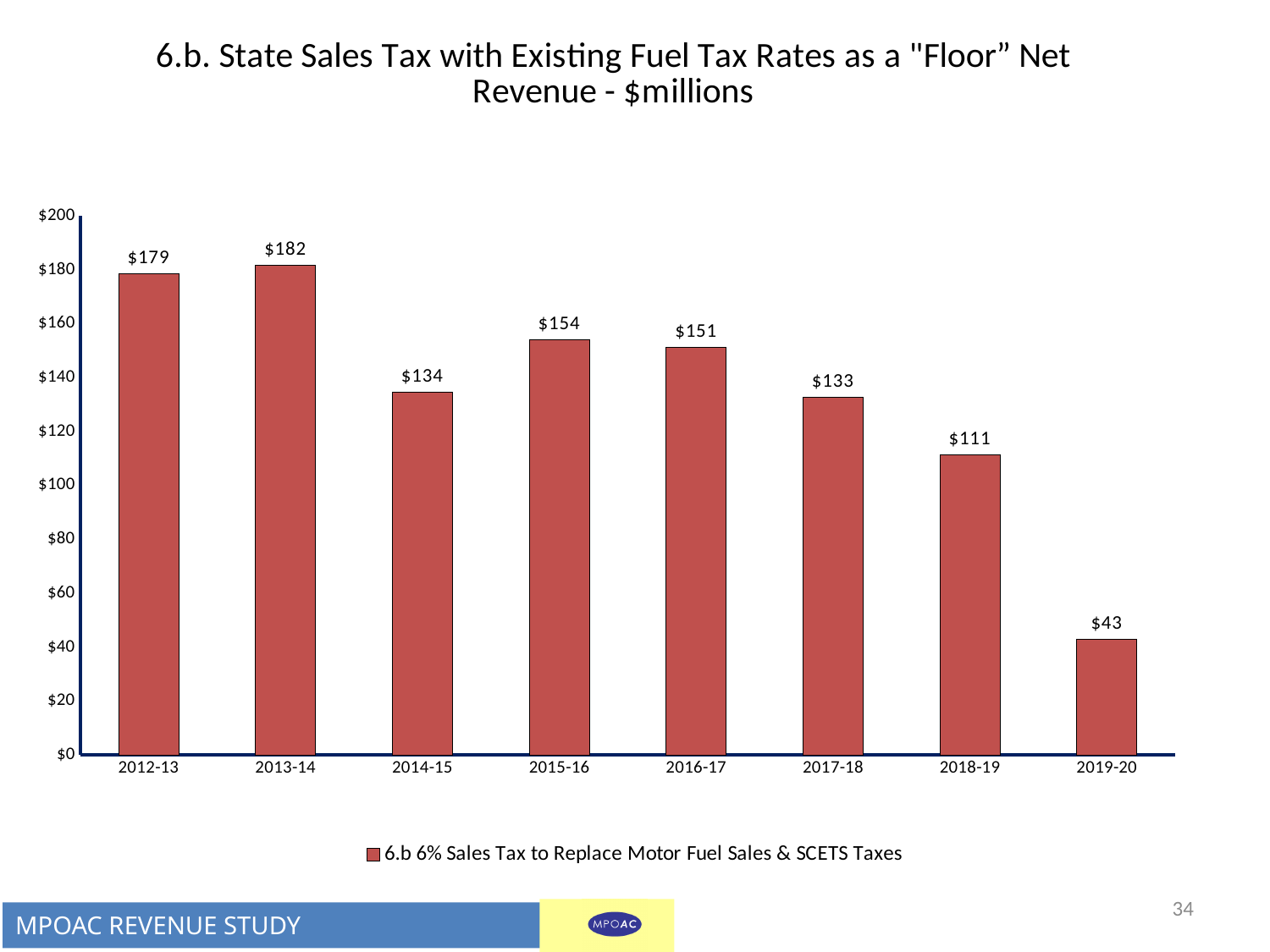
Is the value for 2018-19 greater or less than $120? less How many series does the legend list? 1 Which is larger, the value for 2015-16 or the value for 2017-18? 2015-16 What is the legend entry for the series? 6.b 6% Sales Tax to Replace Motor Fuel Sales & SCETS Taxes What is the value for 2019-20? $43 How many years are shown on the x axis? 8 What kind of chart is shown? bar chart What is the value for 2016-17? $151 What is the value for 2012-13? $179 What is the difference between the values for 2013-14 and 2014-15? $48 Which year has the highest value? 2013-14 Which year has the lowest value? 2019-20